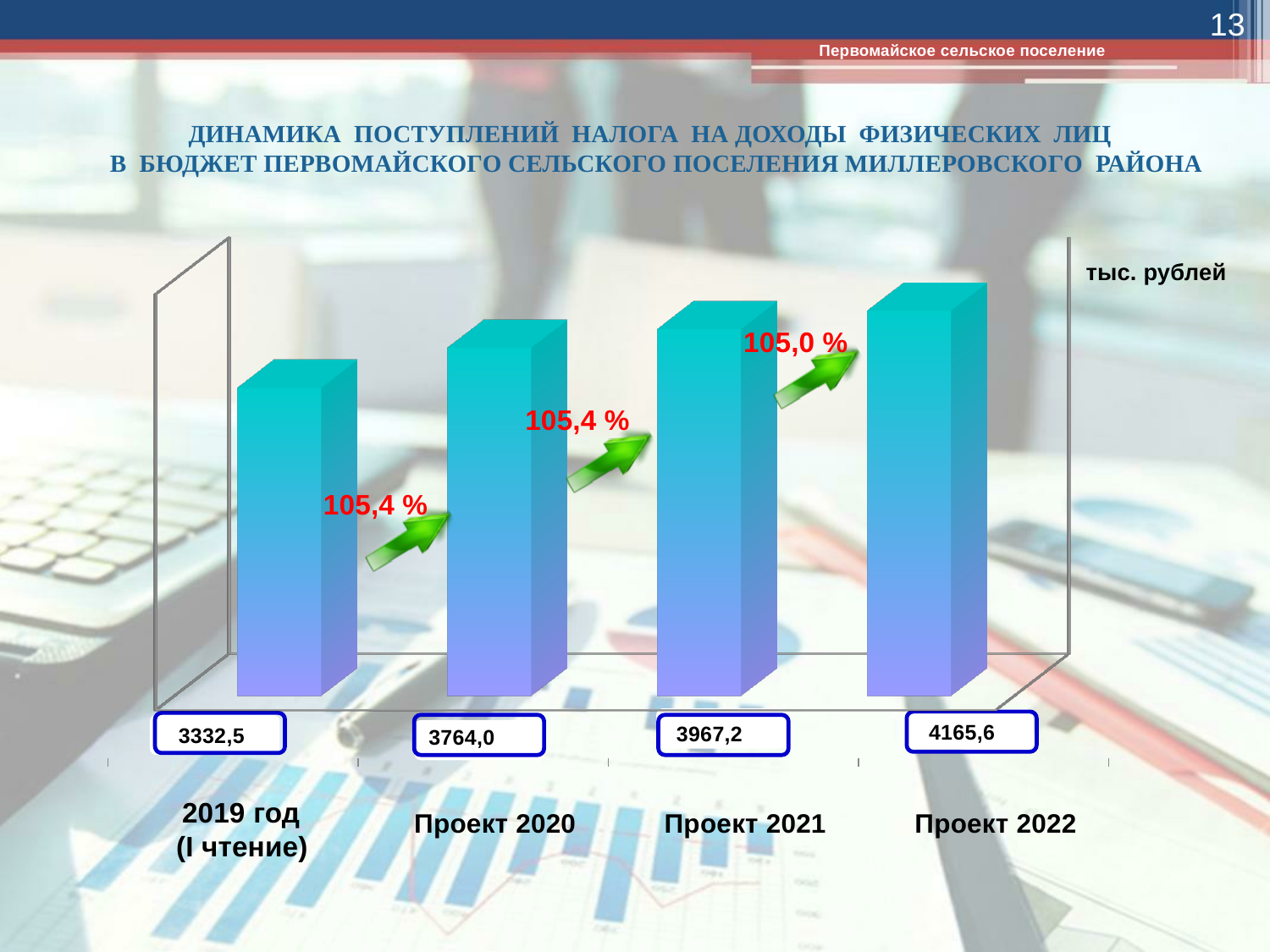
Which category has the lowest value? 2019 год (I чтение) What is the value for Проект 2021? 3967,2 Do the values rise or fall from 2019 год (I чтение) to Проект 2022? Rise How many bars are shown in the chart? 4 Which is larger, the value for Проект 2021 or the value for Проект 2020? Проект 2021 What is the value for Проект 2020? 3764,0 Which category has the highest value? Проект 2022 What is the value for 2019 год (I чтение)? 3332,5 What kind of chart is shown on the slide? Bar chart What is the difference between the values for Проект 2022 and Проект 2021? 198,4 What is the value for Проект 2022? 4165,6 What is the difference between the values for Проект 2020 and 2019 год (I чтение)? 431,5